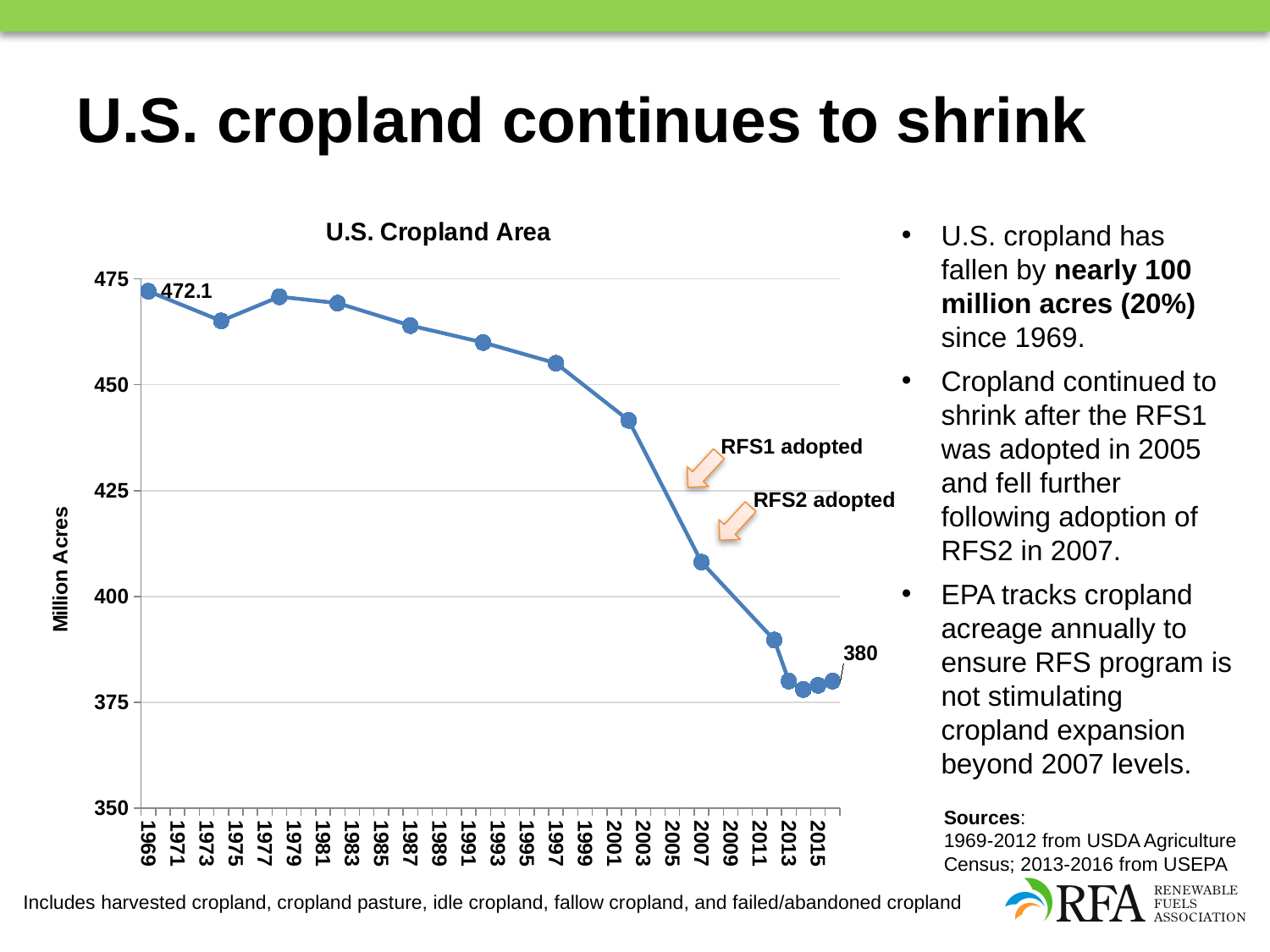
What is the value for 1969 in the U.S. Cropland Area chart? 472.1 Is the value for 2007 in the U.S. Cropland Area chart greater or less than 425? less Which is larger in the U.S. Cropland Area chart, the value for 1987 or the value for 2002? 1987 What is the value labeled at the final data point (2016) in the U.S. Cropland Area chart? 380 What type of chart is the U.S. Cropland Area chart? line chart Is the value for 1997 in the U.S. Cropland Area chart greater or less than 450? greater Which year has the highest cropland area in the U.S. Cropland Area chart? 1969 Is the value for 2012 in the U.S. Cropland Area chart greater or less than 400? less What is the y-axis title of the U.S. Cropland Area chart? Million Acres What two events are annotated with arrows on the U.S. Cropland Area chart? RFS1 adopted and RFS2 adopted What is the difference between the 1969 value (472.1) and the final labeled value (380) in the U.S. Cropland Area chart? 92.1 Do the values in the U.S. Cropland Area chart generally rise or fall from 1969 to 2016? fall